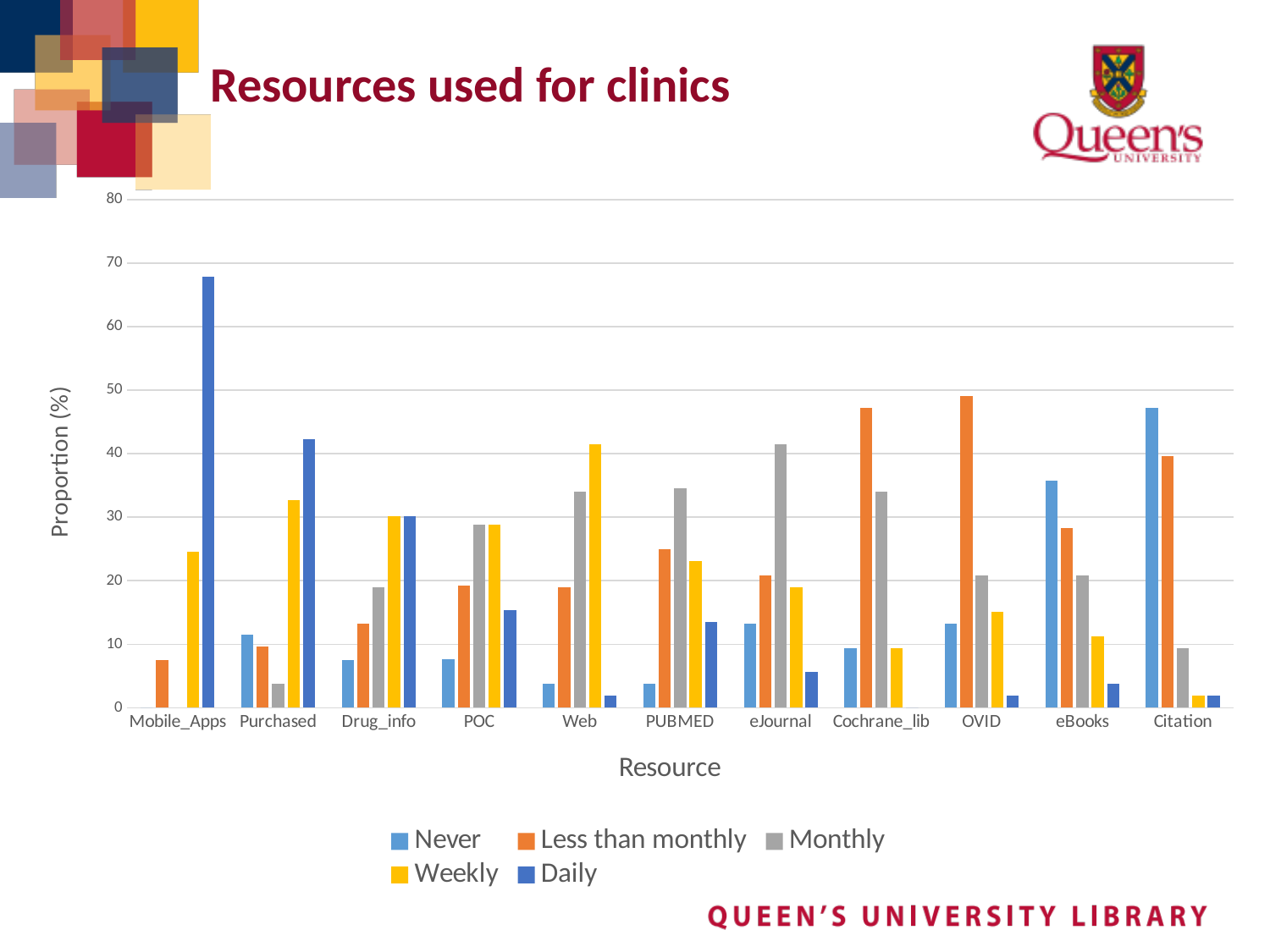
For Citation, which is larger: the Never value or the Less than monthly value? Never Which resource has the highest Never proportion? Citation Which resource has the highest Daily proportion? Mobile_Apps Is the Less than monthly value for OVID greater or less than 40? greater For Web, which is larger: the Weekly value or the Monthly value? Weekly What kind of chart is shown on the slide? Bar chart How many resources are listed along the x axis of the chart? 11 Which series has the highest value for eJournal? Monthly Is the Never value for eBooks greater or less than 30? greater Is the Daily value for Mobile_Apps greater or less than 60? greater What is the label on the chart's vertical axis? Proportion (%) How many series does the chart's legend list? 5